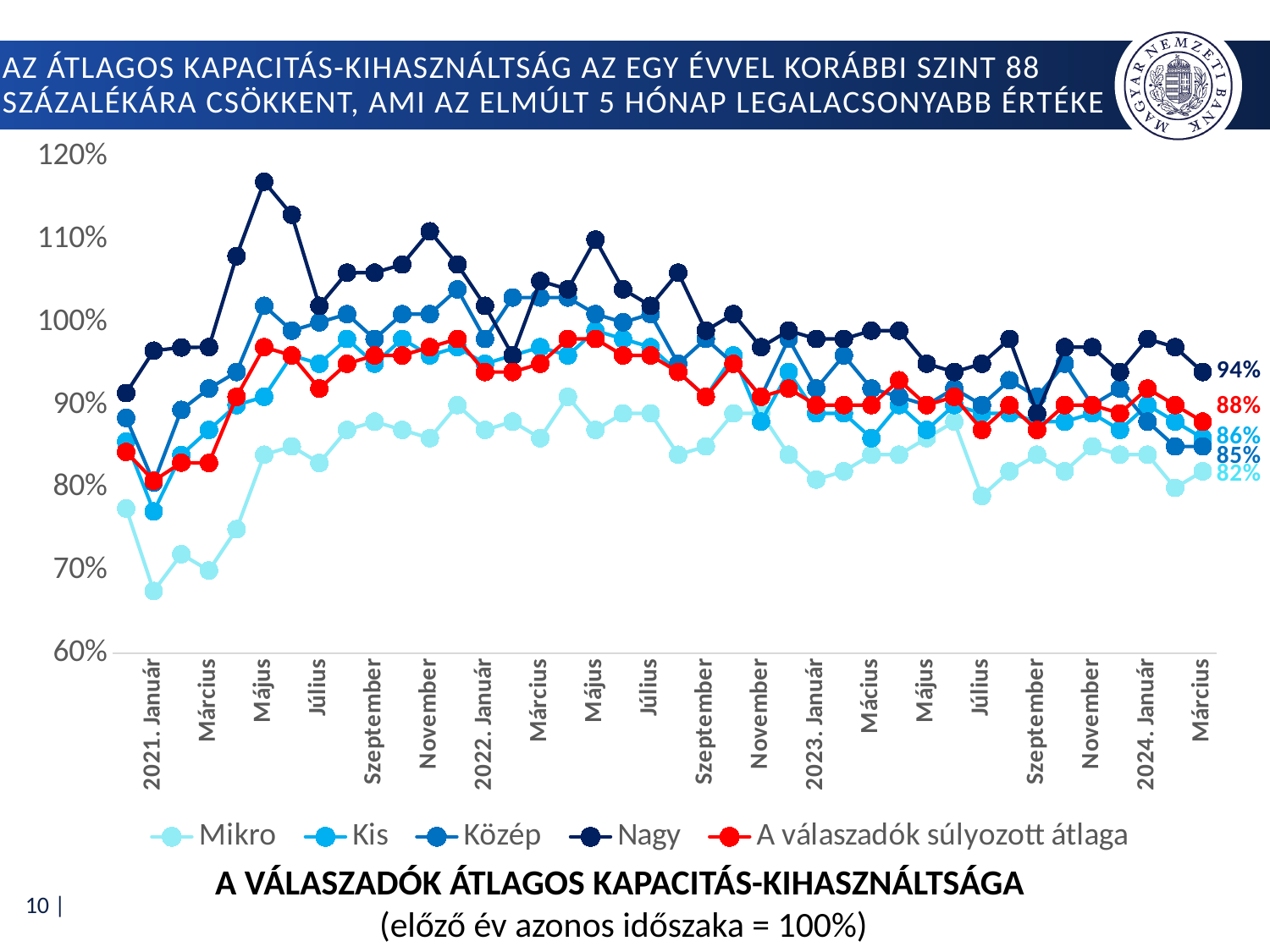
Is the value for Nagy in 2021 Május greater or less than 110%? greater Which series has the highest value at the last point of the chart? Nagy Is the value for Mikro in 2021. Január greater or less than 80%? less What is the title printed below the chart? A VÁLASZADÓK ÁTLAGOS KAPACITÁS-KIHASZNÁLTSÁGA (előző év azonos időszaka = 100%) What is the value of the Nagy series at the last point (2024 Március)? 94% Which series has the lowest value at the last point of the chart? Mikro What is the value of 'A válaszadók súlyozott átlaga' at the last point of the chart? 88% In 2021 Május, which is larger: the Nagy value or the Mikro value? Nagy What is the value of the Mikro series at the last point of the chart? 82% How many series does the legend list? 5 What is the difference between the Nagy and Mikro values at the last point of the chart? 12 percentage points What kind of chart is shown on the slide? line chart